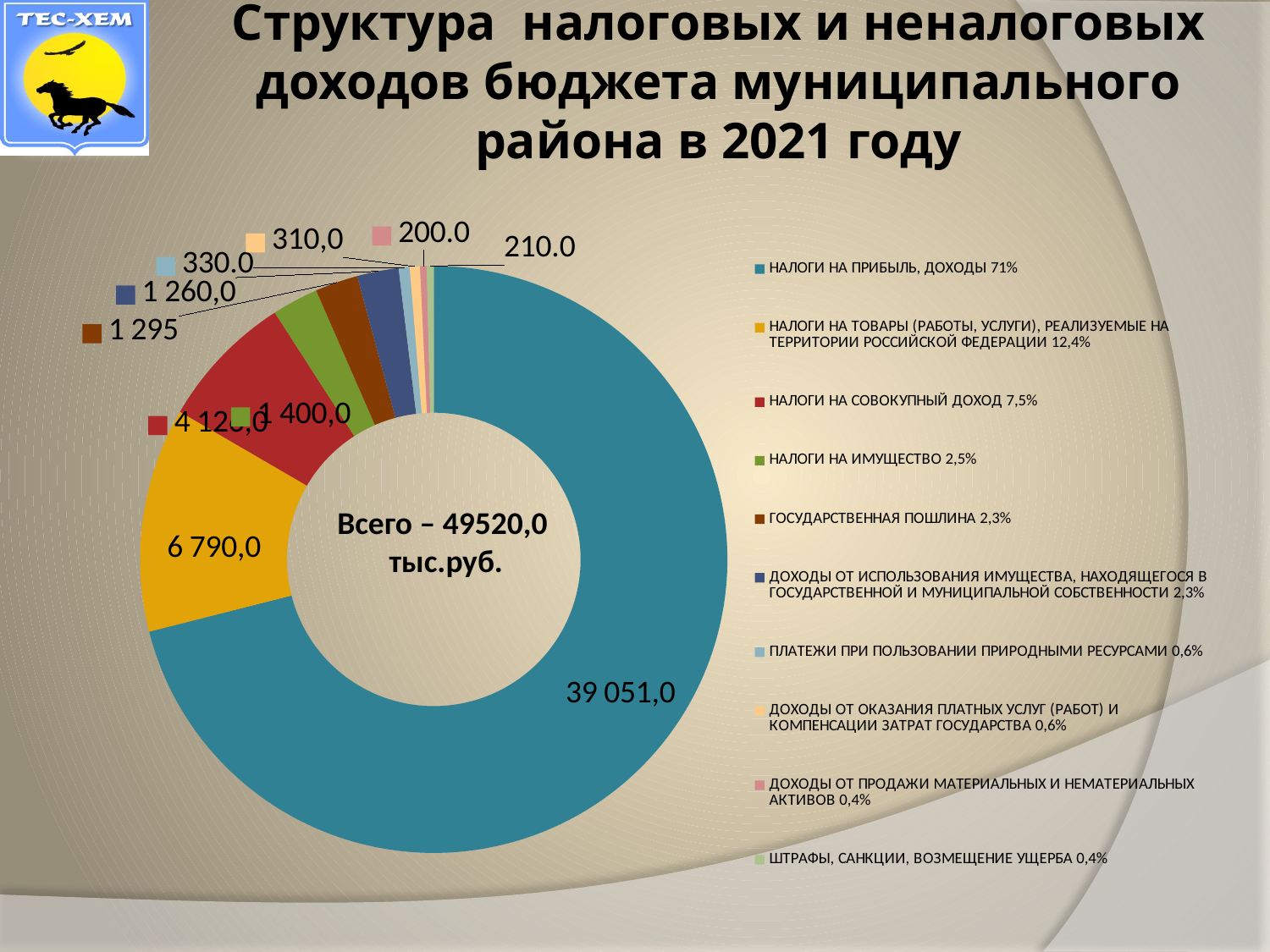
Which category has the smallest value on the chart? ДОХОДЫ ОТ ПРОДАЖИ МАТЕРИАЛЬНЫХ И НЕМАТЕРИАЛЬНЫХ АКТИВОВ (200.0) What is the value shown for НАЛОГИ НА ПРИБЫЛЬ, ДОХОДЫ? 39 051,0 What is the value shown for НАЛОГИ НА ИМУЩЕСТВО? 1 400,0 Which category has the largest share of the chart? НАЛОГИ НА ПРИБЫЛЬ, ДОХОДЫ What kind of chart is shown on the slide? Doughnut (pie) chart Which is larger: the value for ПЛАТЕЖИ ПРИ ПОЛЬЗОВАНИИ ПРИРОДНЫМИ РЕСУРСАМИ or for ДОХОДЫ ОТ ОКАЗАНИЯ ПЛАТНЫХ УСЛУГ (РАБОТ) И КОМПЕНСАЦИИ ЗАТРАТ ГОСУДАРСТВА? ПЛАТЕЖИ ПРИ ПОЛЬЗОВАНИИ ПРИРОДНЫМИ РЕСУРСАМИ (330.0) What share of the total does НАЛОГИ НА СОВОКУПНЫЙ ДОХОД represent according to the legend? 7,5% What is the value shown for НАЛОГИ НА ТОВАРЫ (РАБОТЫ, УСЛУГИ), РЕАЛИЗУЕМЫЕ НА ТЕРРИТОРИИ РОССИЙСКОЙ ФЕДЕРАЦИИ? 6 790,0 What is the value shown for ДОХОДЫ ОТ ИСПОЛЬЗОВАНИЯ ИМУЩЕСТВА, НАХОДЯЩЕГОСЯ В ГОСУДАРСТВЕННОЙ И МУНИЦИПАЛЬНОЙ СОБСТВЕННОСТИ? 1 260,0 What is the difference between the values for НАЛОГИ НА ПРИБЫЛЬ, ДОХОДЫ and НАЛОГИ НА ТОВАРЫ (РАБОТЫ, УСЛУГИ)? 32 261,0 What is the value shown for ГОСУДАРСТВЕННАЯ ПОШЛИНА? 1 295 How many categories does the legend list? 10